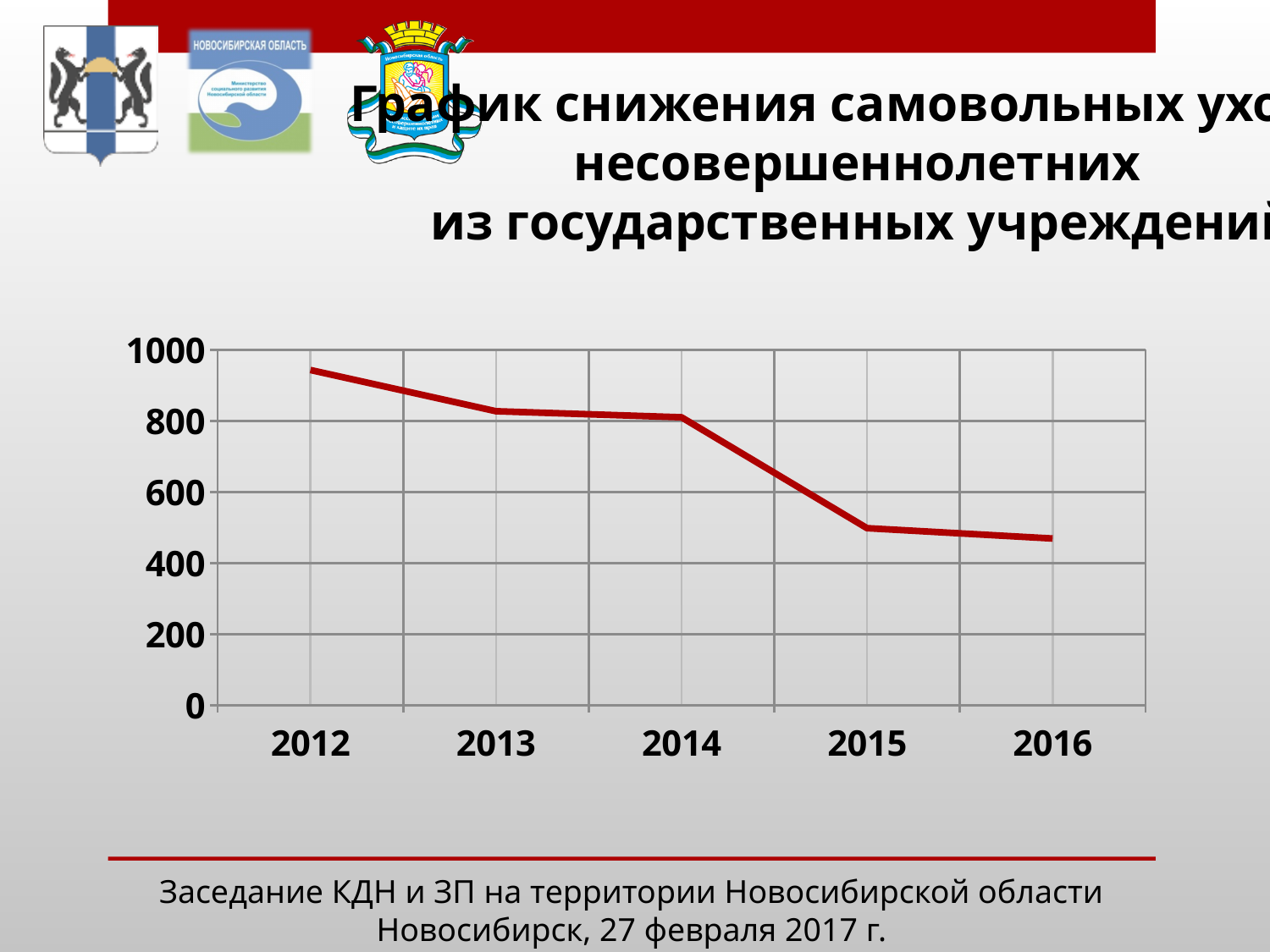
Is the value for 2012 greater or less than 1000? less Is the value for 2015 greater or less than 600? less Is the value for 2012 greater or less than 800? greater Which is larger, the value for 2014 or the value for 2016? 2014 What colour is the plotted line? red What kind of chart is shown on the slide? line chart Do the values rise or fall from 2012 to 2016? fall Which year has the lowest value? 2016 How many years (data points) are plotted on the x axis? 5 Which year has the highest value? 2012 Which is larger, the value for 2012 or the value for 2015? 2012